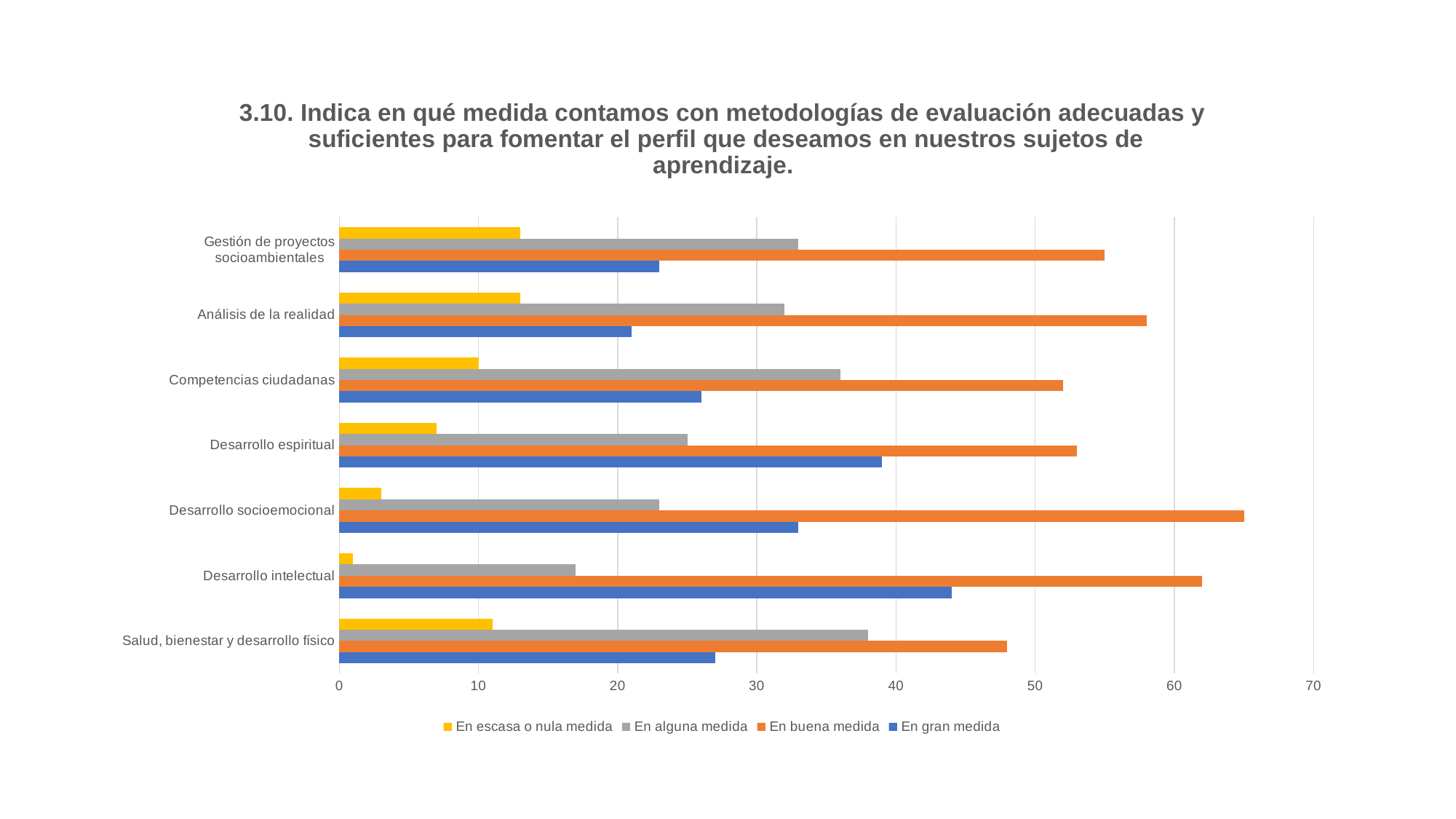
Which category has the lowest value for 'En escasa o nula medida'? Desarrollo intelectual Is the value for 'En buena medida' in Desarrollo socioemocional greater or less than 60? greater Is the value for 'En alguna medida' in Desarrollo intelectual greater or less than 20? less Which category has the highest value for 'En gran medida'? Desarrollo intelectual How many categories are shown on the vertical axis? 7 How many series does the legend list? 4 For Salud, bienestar y desarrollo físico, which is larger: 'En alguna medida' or 'En gran medida'? En alguna medida For Análisis de la realidad, which is larger: 'En escasa o nula medida' or 'En gran medida'? En gran medida What kind of chart is shown on the slide? bar chart Is the value for 'En buena medida' in Gestión de proyectos socioambientales greater or less than 50? greater What colour represents the series 'En buena medida' in the legend? orange Which category has the lowest value for 'En alguna medida'? Desarrollo intelectual